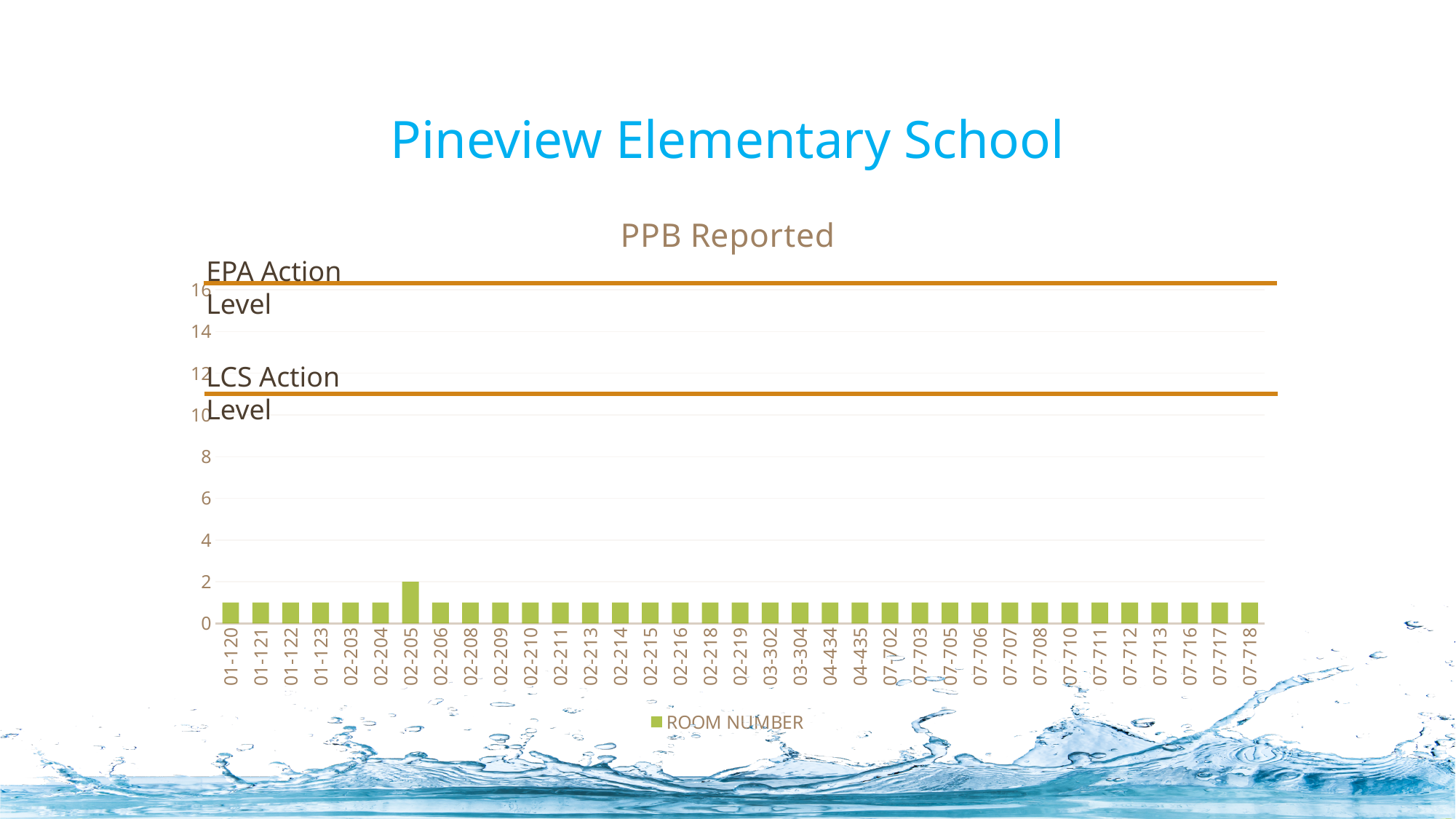
How many series does the chart legend list? 1 What is the title of the chart? PPB Reported What is the name of the series shown in the chart legend? ROOM NUMBER Is the value for room 02-205 greater or less than 10? less Is the value for room 07-718 greater or less than 4? less Which room number has the highest PPB reported value? 02-205 Which has the larger PPB reported value, room 02-205 or room 02-204? 02-205 Is the value for room 03-302 greater or less than 6? less How many room numbers are plotted on the x axis of the chart? 35 What type of chart is shown on the slide? bar chart What is the PPB reported value for room 02-205? 2